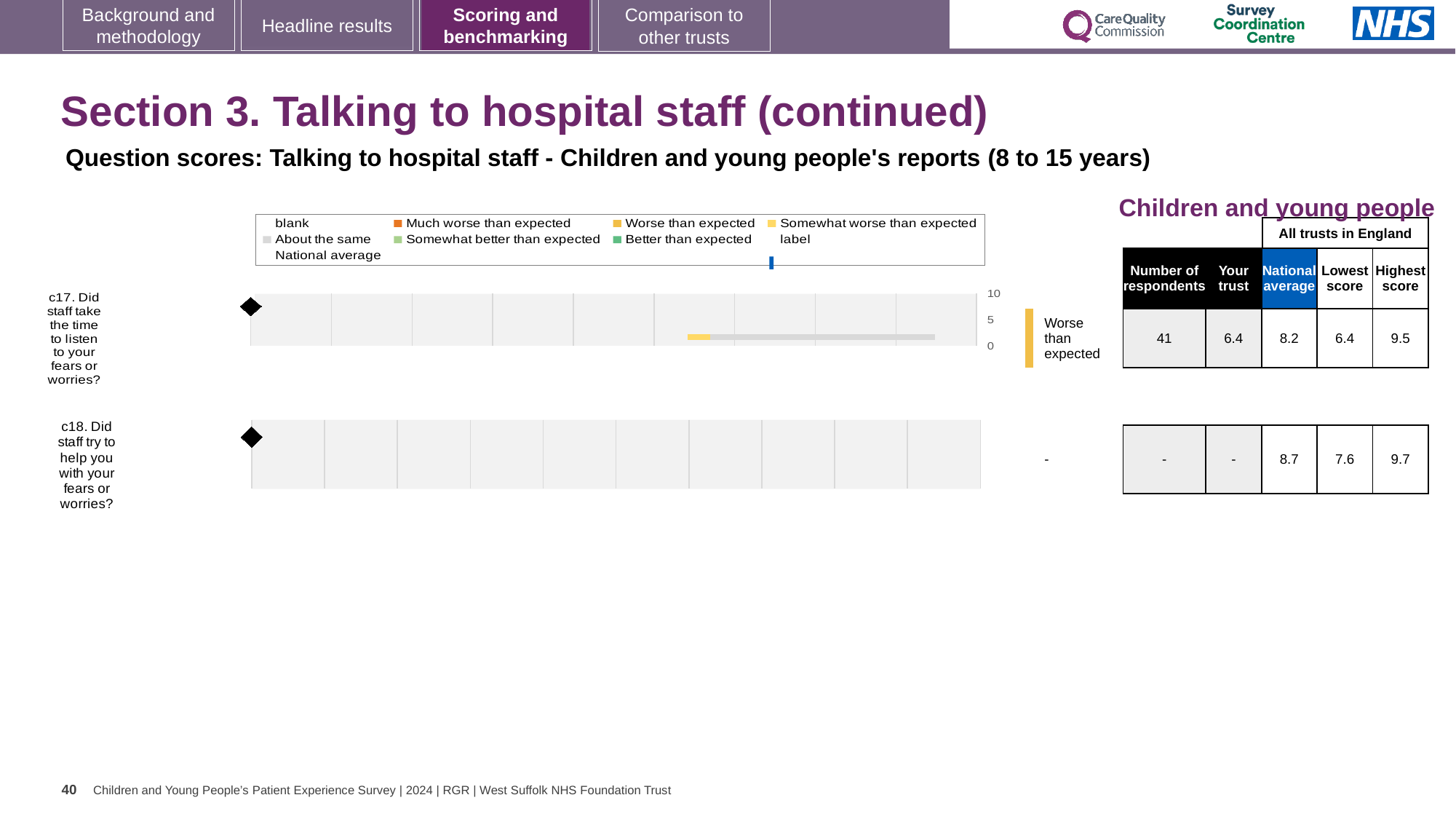
What is the 'Your trust' score for question c17 (Did staff take the time to listen to your fears or worries?)? 6.4 Which question has the higher national average, c17 or c18? c18 Is the trust's score for question c17 greater or less than the national average? less What colour in the legend represents 'Much worse than expected'? Orange How many survey questions are plotted on the chart? 2 What is the highest score among all trusts in England for question c18 (Did staff try to help you with your fears or worries?)? 9.7 What is the national average score for question c17? 8.2 How many respondents answered question c17? 41 What is the lowest score among all trusts in England for question c18? 7.6 How is the trust's result for question c17 categorised relative to expectation? Worse than expected What kind of chart is shown on the slide? Bar chart What is the difference between the national average and the trust's score for question c17? 1.8